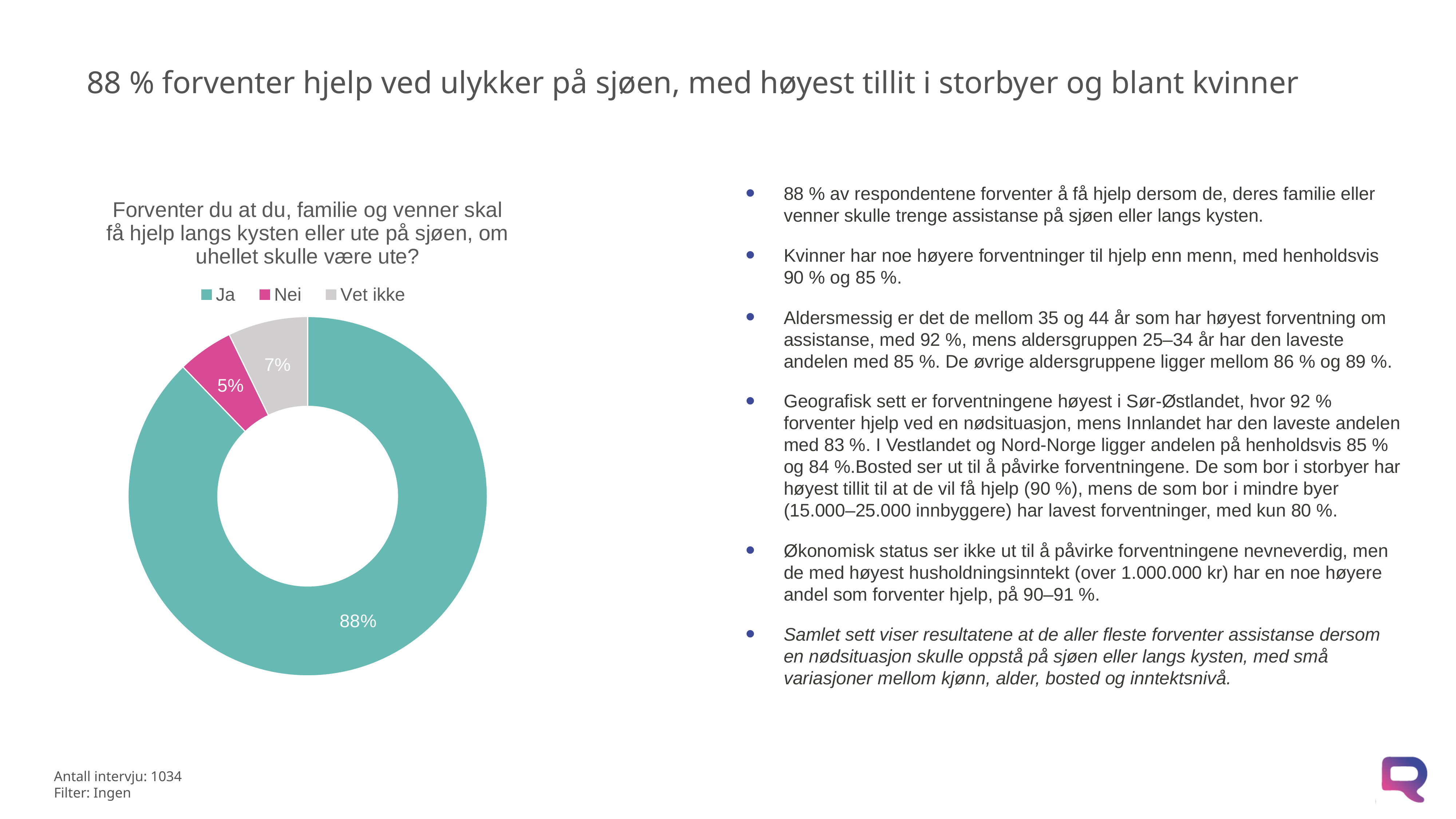
Which is larger, the share for "Nei" or the share for "Vet ikke"? Vet ikke What colour is the "Ja" segment of the chart? Teal Which response category has the smallest share of the chart? Nei Which response category has the largest share of the chart? Ja What is the title of the chart? Forventer du at du, familie og venner skal få hjelp langs kysten eller ute på sjøen, om uhellet skulle være ute? What is the difference in percentage points between "Ja" and "Vet ikke"? 81 How many response categories does the chart show? 3 What kind of chart is shown on the slide? Doughnut chart What percentage of respondents answered "Ja"? 88% What is the difference in percentage points between "Vet ikke" and "Nei"? 2 What percentage of respondents answered "Vet ikke"? 7% What percentage of respondents answered "Nei"? 5%